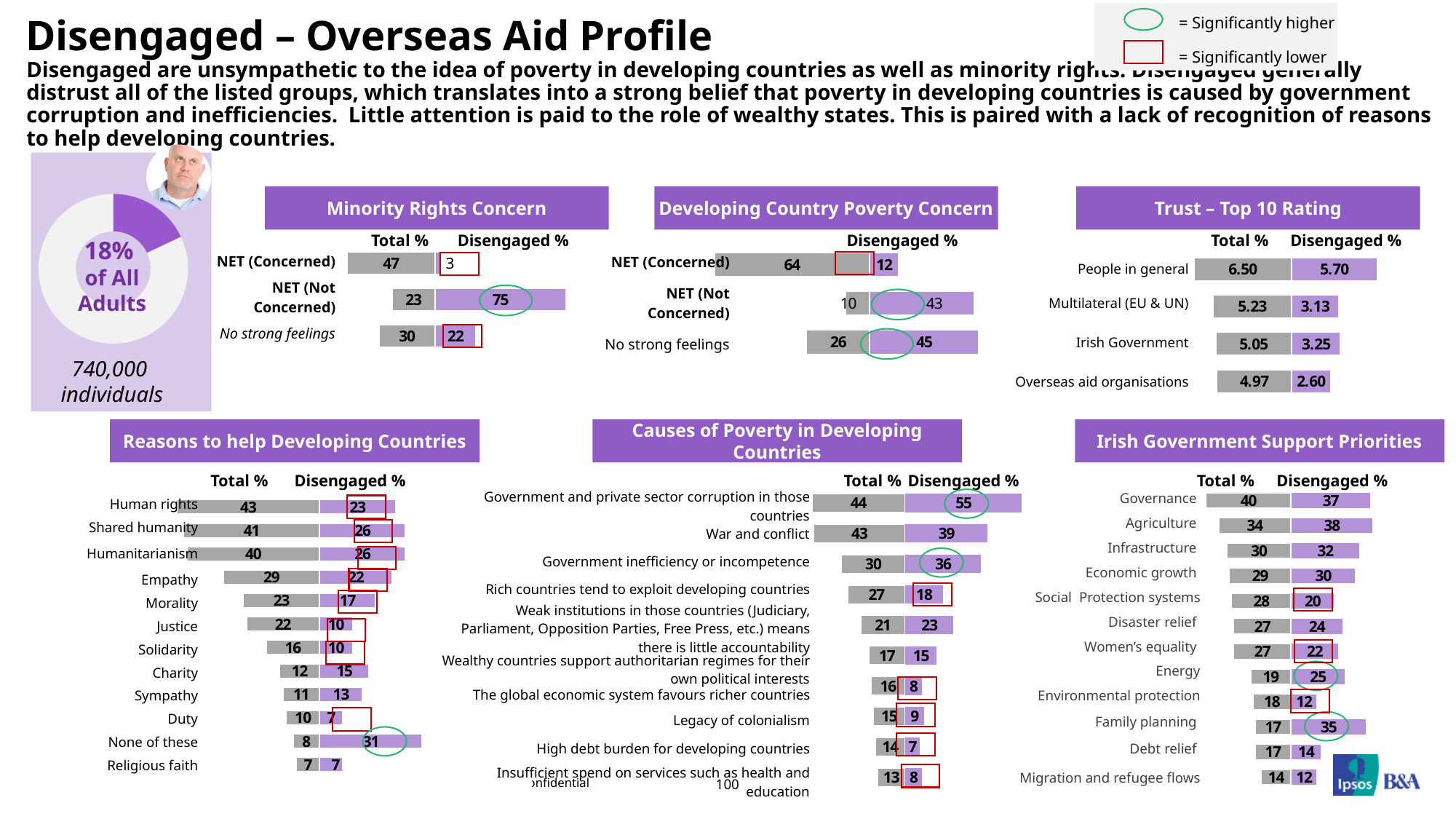
In the Causes of Poverty in Developing Countries chart, is the Disengaged % for War and conflict larger or smaller than the Total %? smaller What share of all adults does the pie chart show for the Disengaged segment? 18% In the Reasons to help Developing Countries chart, what is the difference between the Total % and Disengaged % for Human rights? 20 In the Causes of Poverty in Developing Countries chart, which cause has the highest Disengaged %? Government and private sector corruption in those countries In the Trust – Top 10 Rating chart, which group has the highest Disengaged rating? People in general In the Irish Government Support Priorities chart, what is the Disengaged % for Family planning? 35 What type of chart is the Trust – Top 10 Rating chart? Bar chart In the Irish Government Support Priorities chart, how many priorities are listed? 12 In the Trust – Top 10 Rating chart, what is the Disengaged % rating for Overseas aid organisations? 2.60 In the Minority Rights Concern chart, what is the Disengaged % for NET (Not Concerned)? 75 In the Reasons to help Developing Countries chart, which reason has the lowest Disengaged %? Duty and Religious faith (both 7) In the Developing Country Poverty Concern chart, what is the Disengaged % for NET (Concerned)? 12